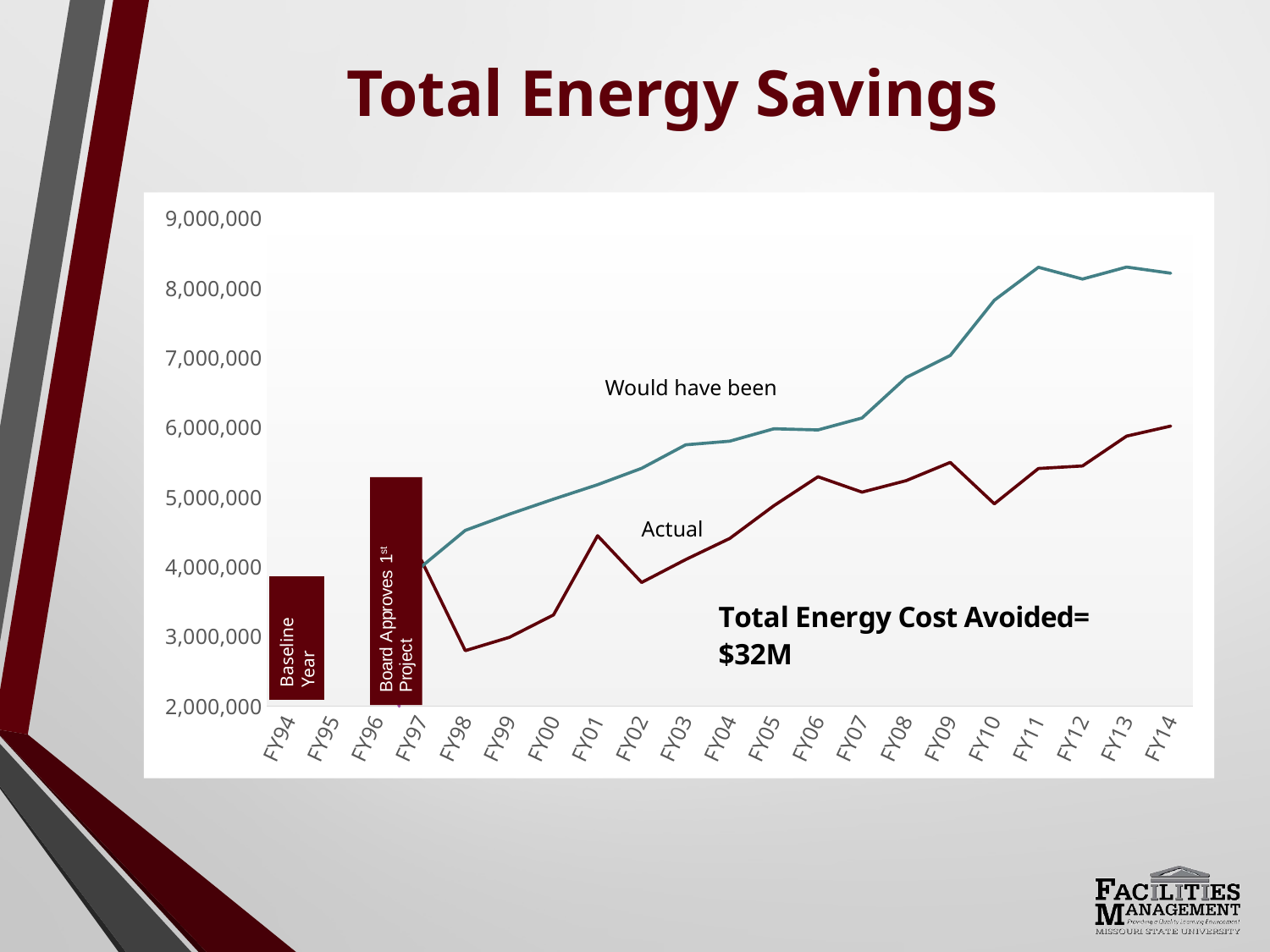
Is the value of the Actual line at FY01 greater or less than 5,000,000? less What kind of chart is shown on the slide? line chart Is the value of the Would have been line at FY11 greater or less than 8,000,000? greater How many lines (series) are plotted on the chart? 2 How many fiscal years are shown along the x axis of the chart? 21 In which fiscal year does the Actual line reach its lowest value? FY98 At FY10, which line has the higher value, Would have been or Actual? Would have been Is the value of the Actual line at FY06 greater or less than 5,000,000? greater What total energy cost avoided amount is stated on the chart? $32M Does the Would have been line generally rise or fall from FY97 to FY14? rise